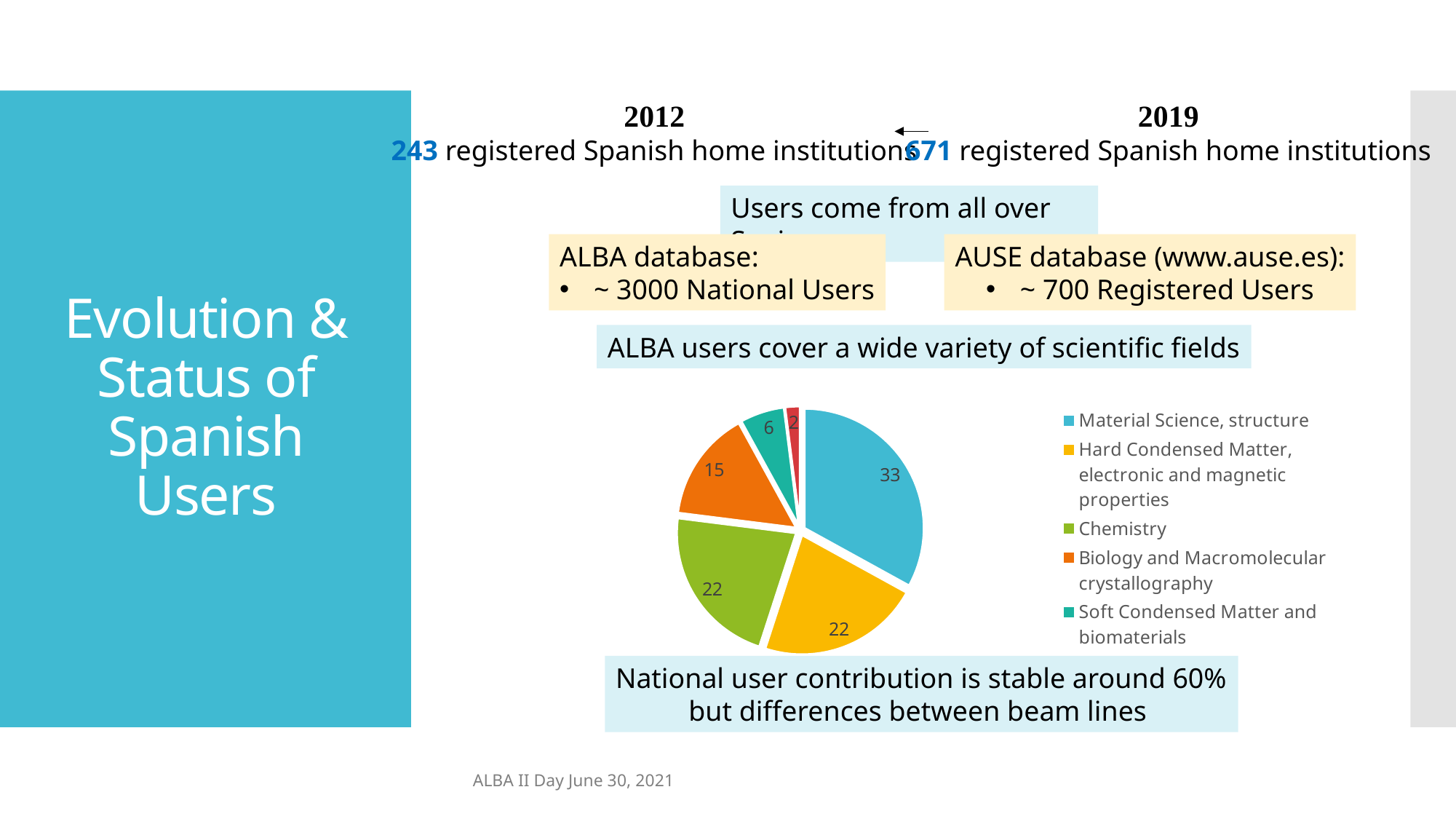
Which category has the largest slice in the pie chart? Material Science, structure What value is shown for Chemistry in the pie chart? 22 What value is shown for Soft Condensed Matter and biomaterials in the pie chart? 6 What is the smallest value labelled on the pie chart? 2 Which is larger in the pie chart: Material Science, structure or Chemistry? Material Science, structure What kind of chart is shown on the slide? pie chart What is the difference between the values for Chemistry and Soft Condensed Matter and biomaterials? 16 What value is shown for Biology and Macromolecular crystallography in the pie chart? 15 What value is shown for Material Science, structure in the pie chart? 33 What is the difference between the values for Material Science, structure and Biology and Macromolecular crystallography? 18 How many entries does the pie chart's legend list? 5 How many slices does the pie chart have? 6